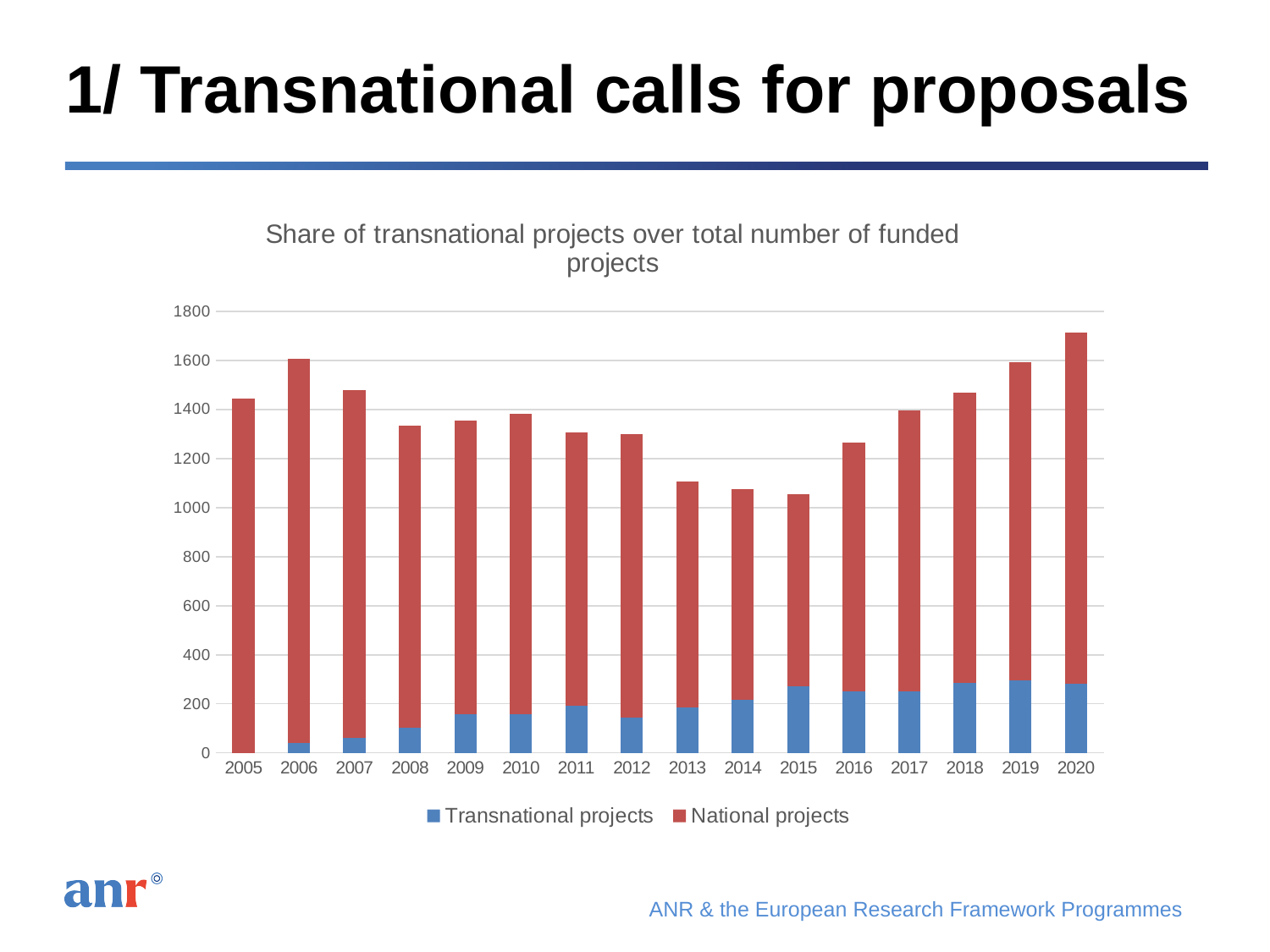
How many series does the legend list? 2 Which year has the highest total number of funded projects? 2020 Is the total number of funded projects in 2015 greater or less than 1200? less How many years are shown on the x axis? 16 Is the total number of funded projects in 2020 greater or less than 1600? greater Which year has the larger total number of funded projects, 2006 or 2007? 2006 Is the number of transnational projects in 2008 greater or less than 200? less What kind of chart is shown on the slide? Stacked bar chart Do the total numbers of funded projects rise or fall from 2015 to 2020? rise Which year has more transnational projects, 2008 or 2015? 2015 What is the title of the chart? Share of transnational projects over total number of funded projects